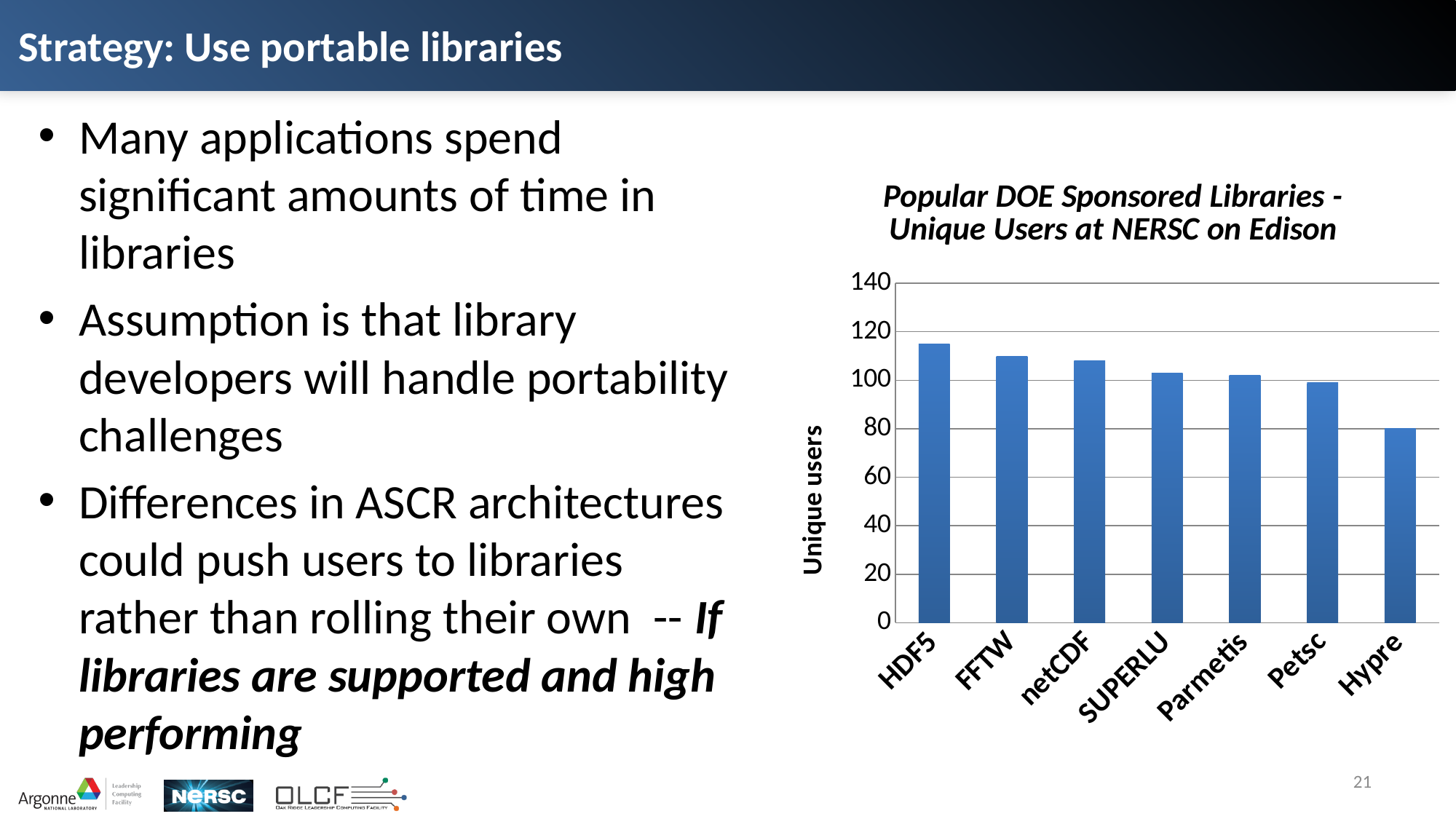
What is the title of the chart? Popular DOE Sponsored Libraries - Unique Users at NERSC on Edison What kind of chart is shown on the slide? bar chart Is the value for HDF5 greater or less than 100? greater Is the value for HDF5 greater or less than 120? less Do the values rise or fall from left to right along the x axis? fall Is the value for Hypre greater or less than 100? less Which library has the highest number of unique users? HDF5 Which has more unique users, FFTW or Hypre? FFTW Which library has the lowest number of unique users? Hypre How many libraries are shown on the x axis of the chart? 7 What is the label on the vertical axis of the chart? Unique users